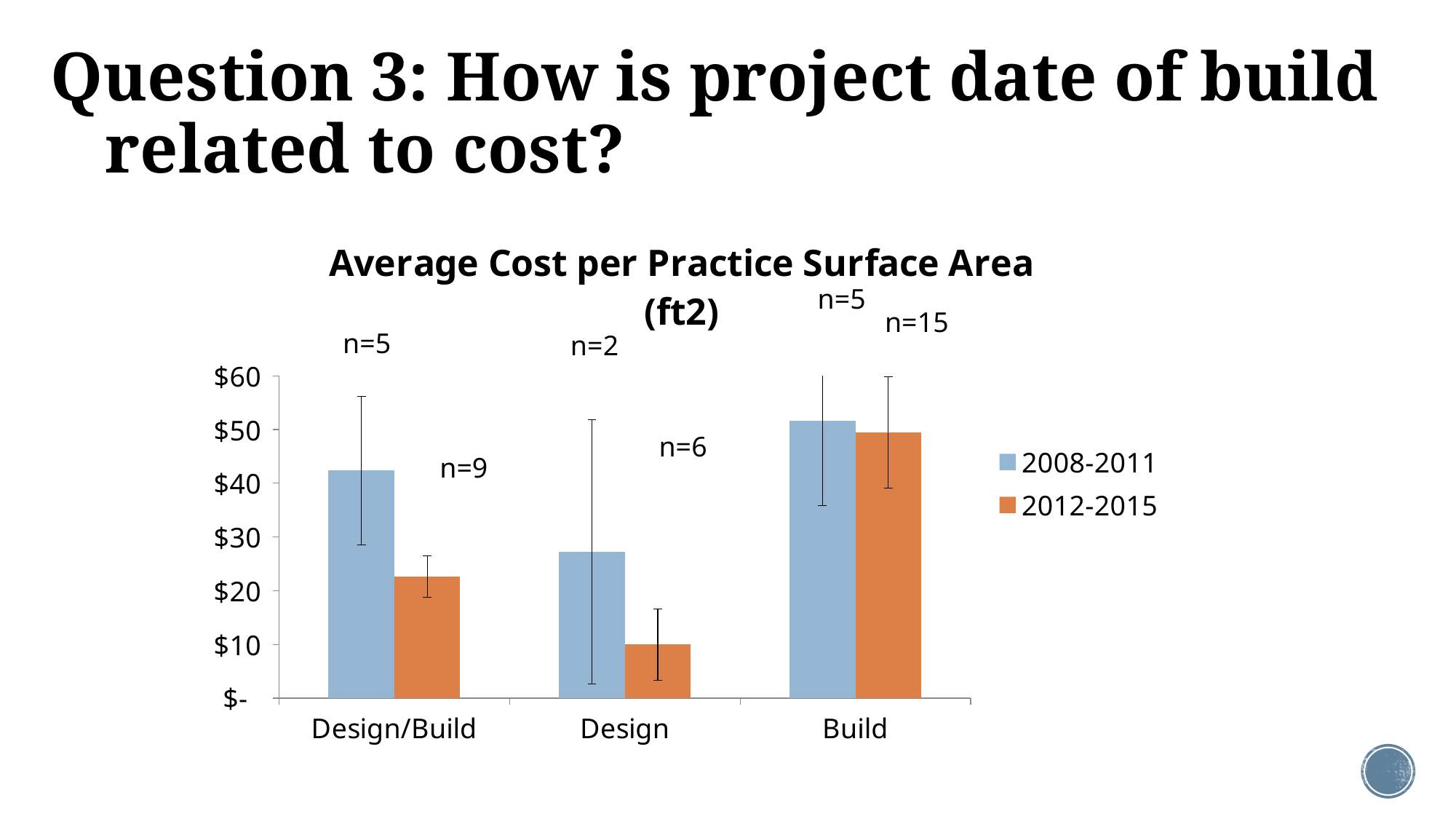
What is the sample size (n) shown for the Build 2012-2015 bar? n=15 Which category has the highest value for the 2008-2011 series? Build Is the value for Design/Build in the 2008-2011 series greater or less than $30? greater How many categories are shown on the x axis? 3 For Design, which series has the larger value, 2008-2011 or 2012-2015? 2008-2011 Is the value for Design in the 2012-2015 series greater or less than $20? less What kind of chart is shown on the slide? bar chart Which category has the lowest value for the 2012-2015 series? Design Is the value for Design in the 2008-2011 series greater or less than $30? less For Design/Build, which series has the larger value, 2008-2011 or 2012-2015? 2008-2011 How many series does the legend list? 2